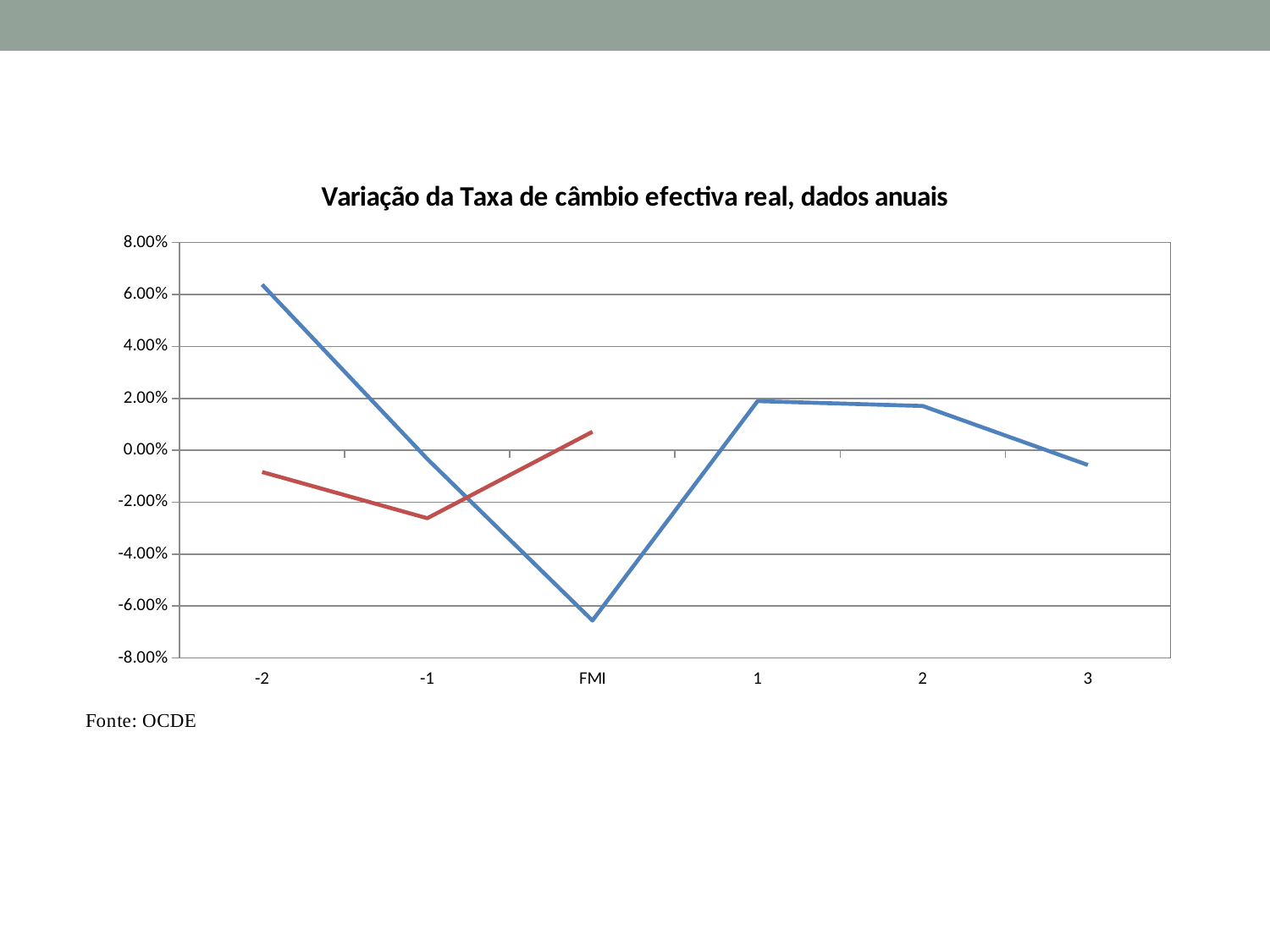
Is the value of the blue line at FMI greater or less than -6.00%? less Does the blue line rise or fall from -2 to FMI? fall Is the value of the blue line at -2 greater or less than 6.00%? greater What kind of chart is shown on the slide? line chart How many lines are plotted on the chart? 2 At which x-axis category does the red line reach its lowest value? -1 At which x-axis category does the blue line reach its highest value? -2 Is the value of the red line at -1 greater or less than -2.00%? less At which x-axis category does the blue line reach its lowest value? FMI Which line has the higher value at FMI, the blue line or the red line? the red line What is the title of the chart? Variação da Taxa de câmbio efectiva real, dados anuais How many categories are shown on the x axis of the chart? 6